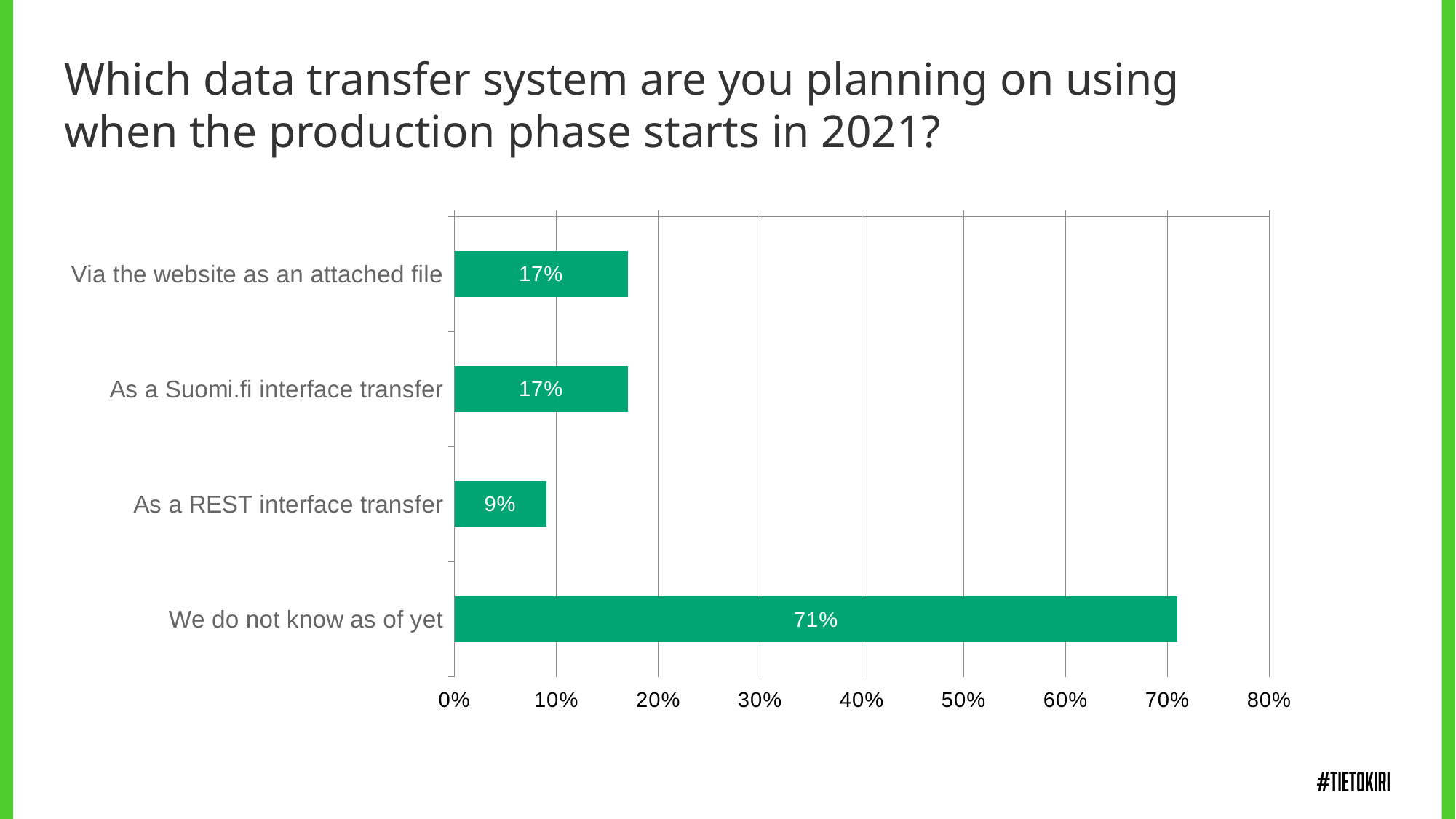
Which is larger: the value for "As a Suomi.fi interface transfer" or "As a REST interface transfer"? As a Suomi.fi interface transfer Which category has the highest value? We do not know as of yet What kind of chart is shown on the slide? Bar chart Is the value for "We do not know as of yet" greater or less than 50%? greater How many categories are shown in the chart? 4 Which category has the lowest value? As a REST interface transfer What is the value for "Via the website as an attached file"? 17% What is the value for "As a Suomi.fi interface transfer"? 17% What is the value for "As a REST interface transfer"? 9% What percentage of respondents answered "We do not know as of yet"? 71% What is the difference between "We do not know as of yet" and "As a REST interface transfer"? 62% What is the difference between "As a Suomi.fi interface transfer" and "As a REST interface transfer"? 8%